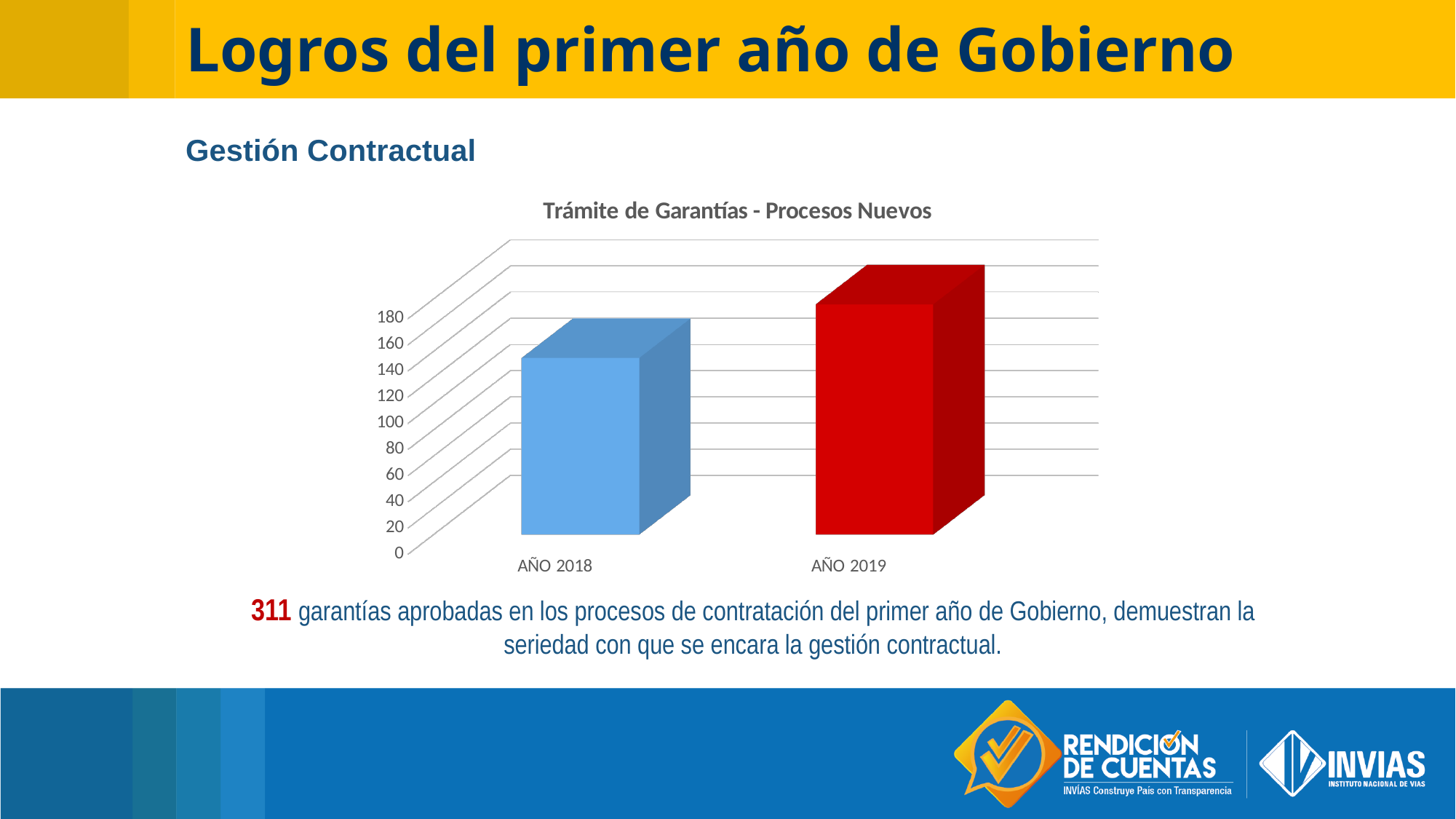
What is the highest value shown on the vertical axis of the chart? 180 How many categories are plotted in the chart? 2 What is the title of the chart? Trámite de Garantías - Procesos Nuevos Which category has the lowest value in the chart? AÑO 2018 Is the value for AÑO 2018 greater or less than 100? greater Which category has the highest value in the chart? AÑO 2019 What kind of chart is shown on the slide? bar chart Do the values rise or fall from AÑO 2018 to AÑO 2019? rise Which is larger, the value for AÑO 2018 or the value for AÑO 2019? AÑO 2019 What colour is the bar for AÑO 2019? red Is the value for AÑO 2018 greater or less than 160? less Is the value for AÑO 2019 greater or less than 140? greater